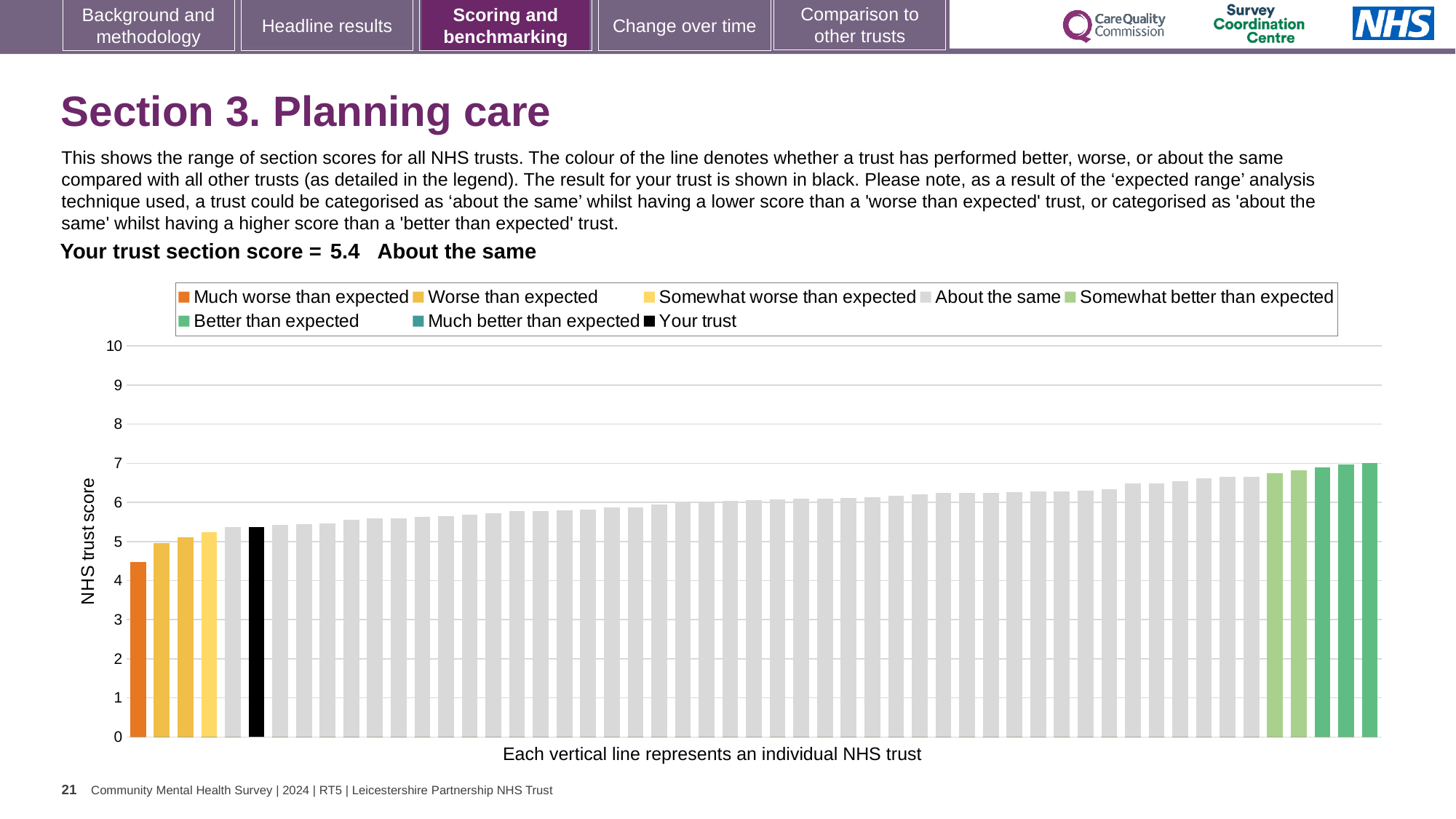
Is the value of the black 'Your trust' bar greater or less than 6? less Is the value of the rightmost bar greater or less than 6? greater What is the label on the vertical axis of the chart? NHS trust score Which legend category does the highest-scoring trust belong to? Better than expected How many bars are coloured as 'Better than expected'? 3 Do the bar values rise or fall from left to right along the x axis? rise Which legend category does the lowest-scoring trust belong to? Much worse than expected What is the section score for your trust? 5.4 What kind of chart is shown on the slide? bar chart Is the value of the lowest bar (Much worse than expected) greater or less than 5? less Which performance category is your trust placed in for Section 3. Planning care? About the same How many entries does the chart legend list? 8